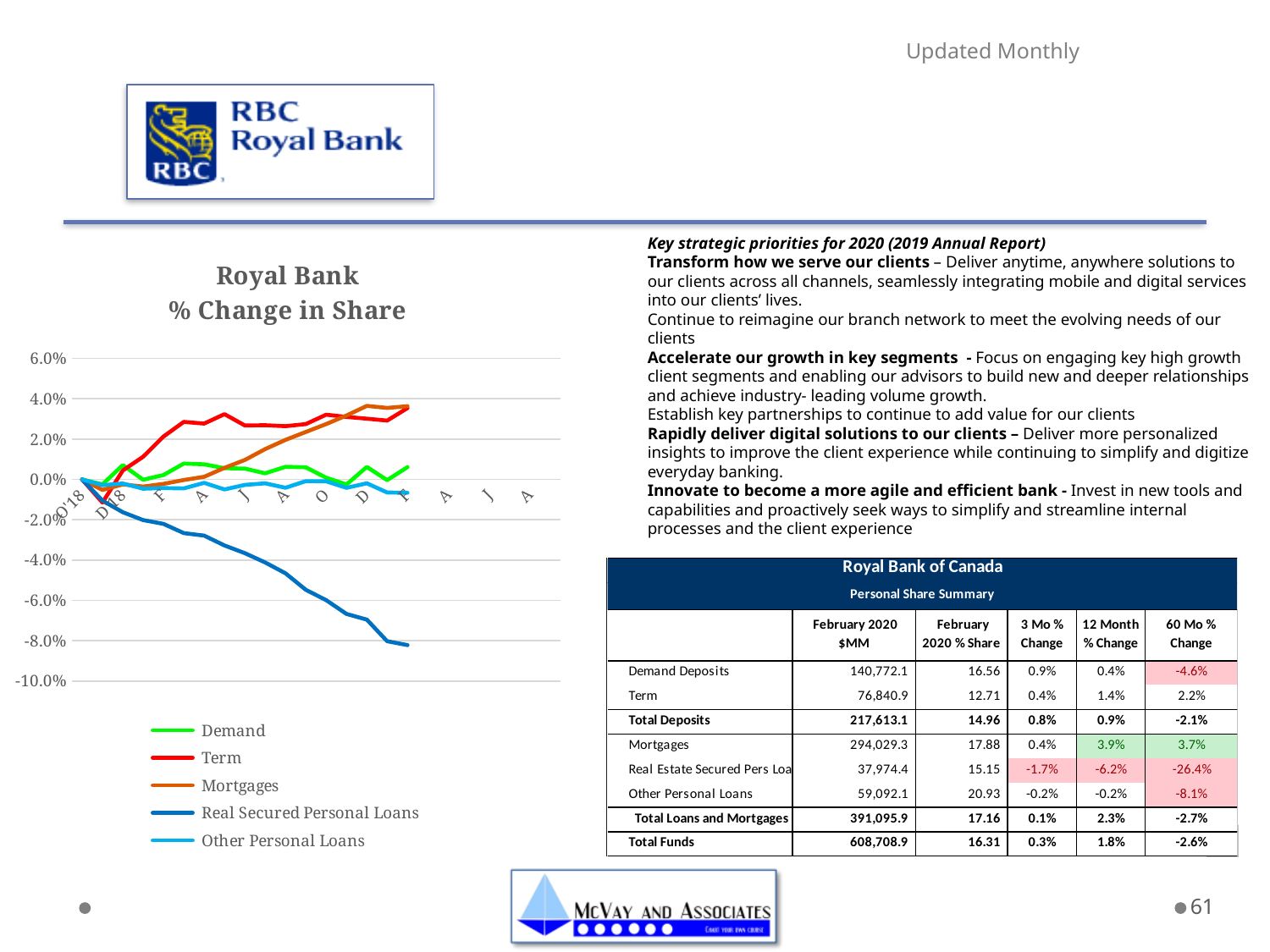
Is the final plotted value for Term greater or less than 2.0%? greater Is the final plotted value for Mortgages greater or less than 2.0%? greater Which colour is used for the Demand line in the chart? Green Does the Real Secured Personal Loans line rise or fall along the x axis? Fall Which series has the lowest value at the end of the plotted period? Real Secured Personal Loans What kind of chart is shown on the slide? Line chart At the end of the plotted period, which is larger: the value for Mortgages or the value for Real Secured Personal Loans? Mortgages How many series does the legend of the chart list? 5 What is the title of the chart? Royal Bank % Change in Share What is the highest value shown on the y axis of the chart? 6.0% Does the Mortgages line rise or fall along the x axis? Rise Is the final plotted value for Real Secured Personal Loans greater or less than -6.0%? less